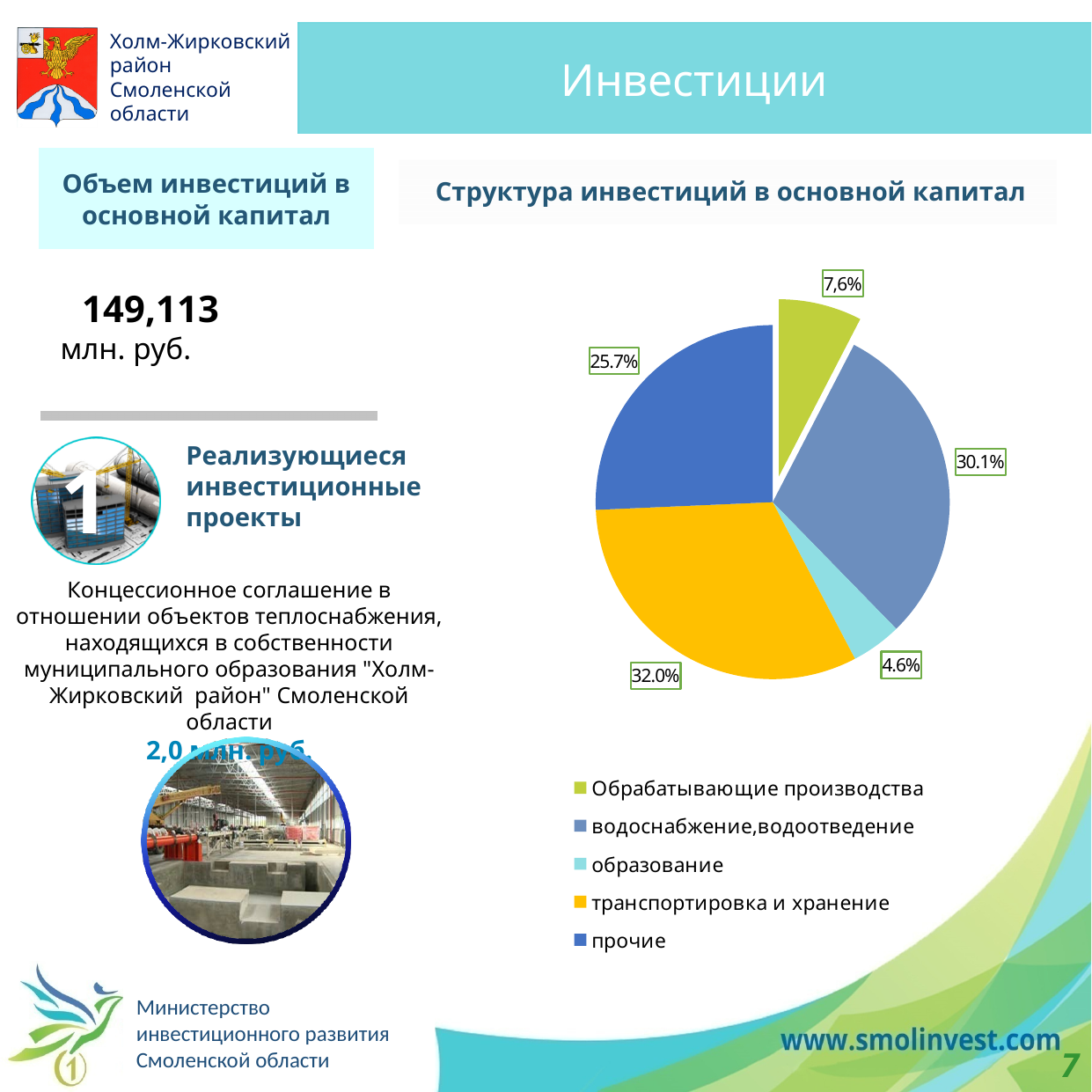
What kind of chart is shown under the heading "Структура инвестиций в основной капитал"? pie chart What share of the pie chart does "образование" have? 4.6% Which category has the largest slice in the pie chart? транспортировка и хранение What share of the pie chart does "водоснабжение,водоотведение" have? 30.1% Which category has the smallest slice in the pie chart? образование What is the difference in percentage points between "транспортировка и хранение" and "прочие" in the pie chart? 6.3 What share of the pie chart does "прочие" have? 25.7% What share of the pie chart does "Обрабатывающие производства" have? 7,6% What share of the pie chart does "транспортировка и хранение" have? 32.0% Which is larger in the pie chart: "прочие" or "водоснабжение,водоотведение"? водоснабжение,водоотведение What colour is the "транспортировка и хранение" slice in the pie chart? yellow How many categories does the pie chart's legend list? 5